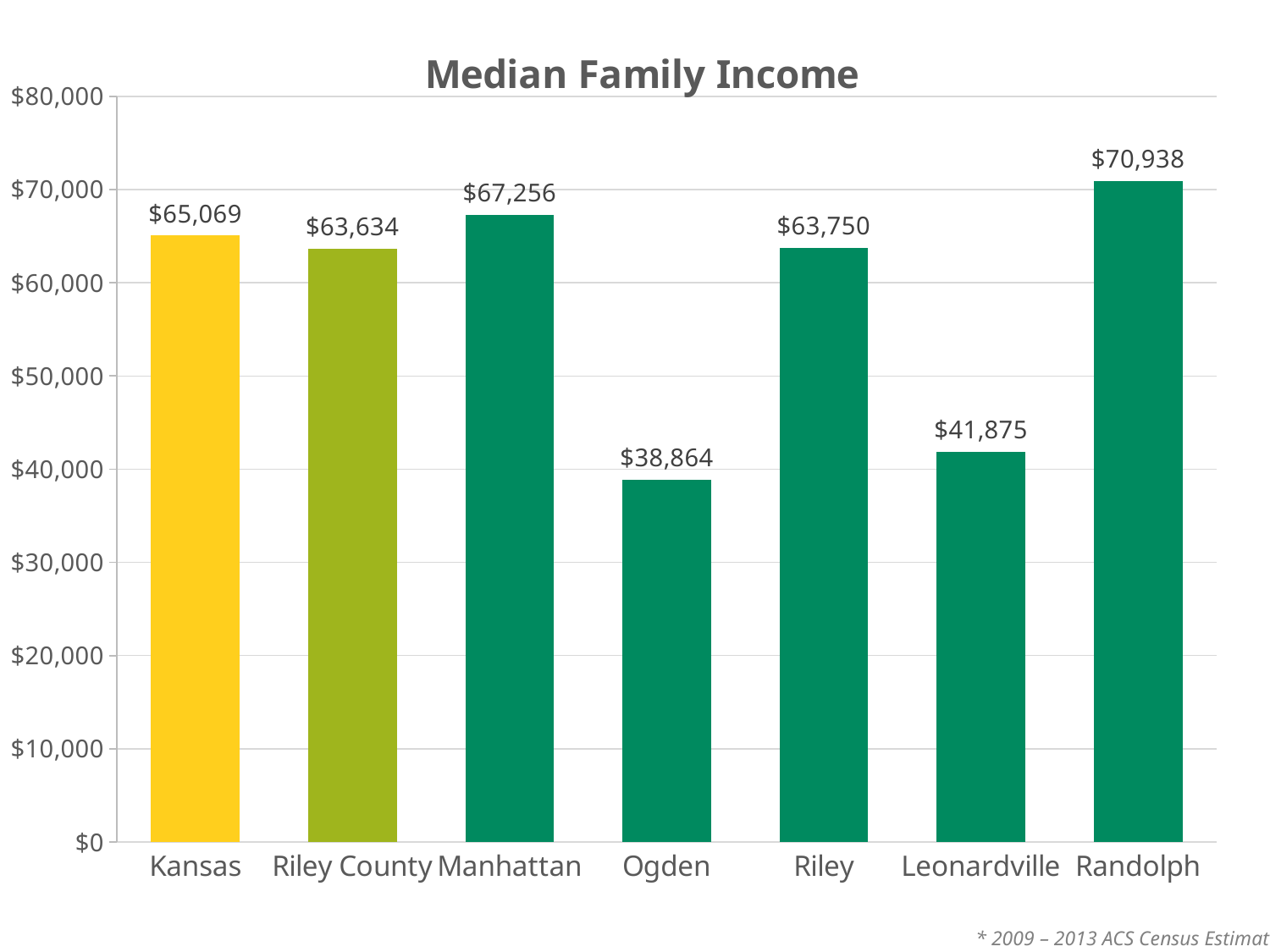
What is the median family income for Manhattan? $67,256 Which category has the lowest median family income? Ogden Is the median family income for Leonardville greater or less than $40,000? greater What is the title of the chart? Median Family Income What is the median family income for Ogden? $38,864 Which category has the highest median family income? Randolph What is the difference between the median family income of Randolph and Ogden? $32,074 What kind of chart is this? Bar chart What is the difference between the median family income of Manhattan and Kansas? $2,187 Which has a higher median family income, Leonardville or Riley? Riley How many categories are shown on the chart? 7 What is the median family income for Kansas? $65,069